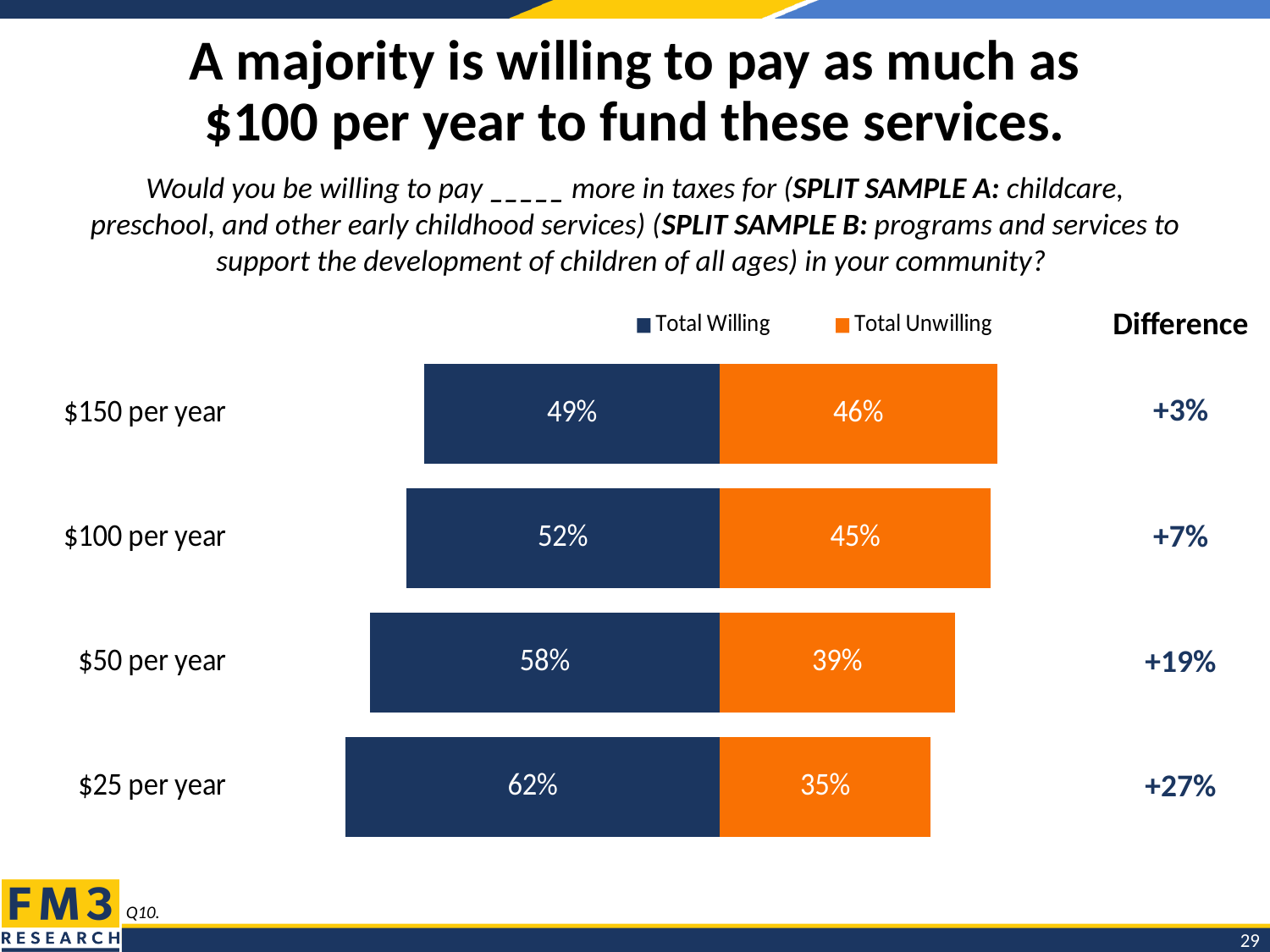
What is the Difference value shown for $100 per year? +7% What kind of chart is shown on the slide? Bar chart Which amount has the lowest Total Unwilling percentage? $25 per year What percentage is Total Willing for $100 per year? 52% What is the Total Willing value for $25 per year? 62% Is Total Willing or Total Unwilling larger for $150 per year? Total Willing Which amount has the highest Total Willing percentage? $25 per year Which colour represents Total Unwilling in the chart? Orange How many payment amounts are shown in the chart? 4 What percentage is Total Unwilling for $150 per year? 46% How many series does the legend list? 2 What is the difference between Total Willing and Total Unwilling for $50 per year? 19%